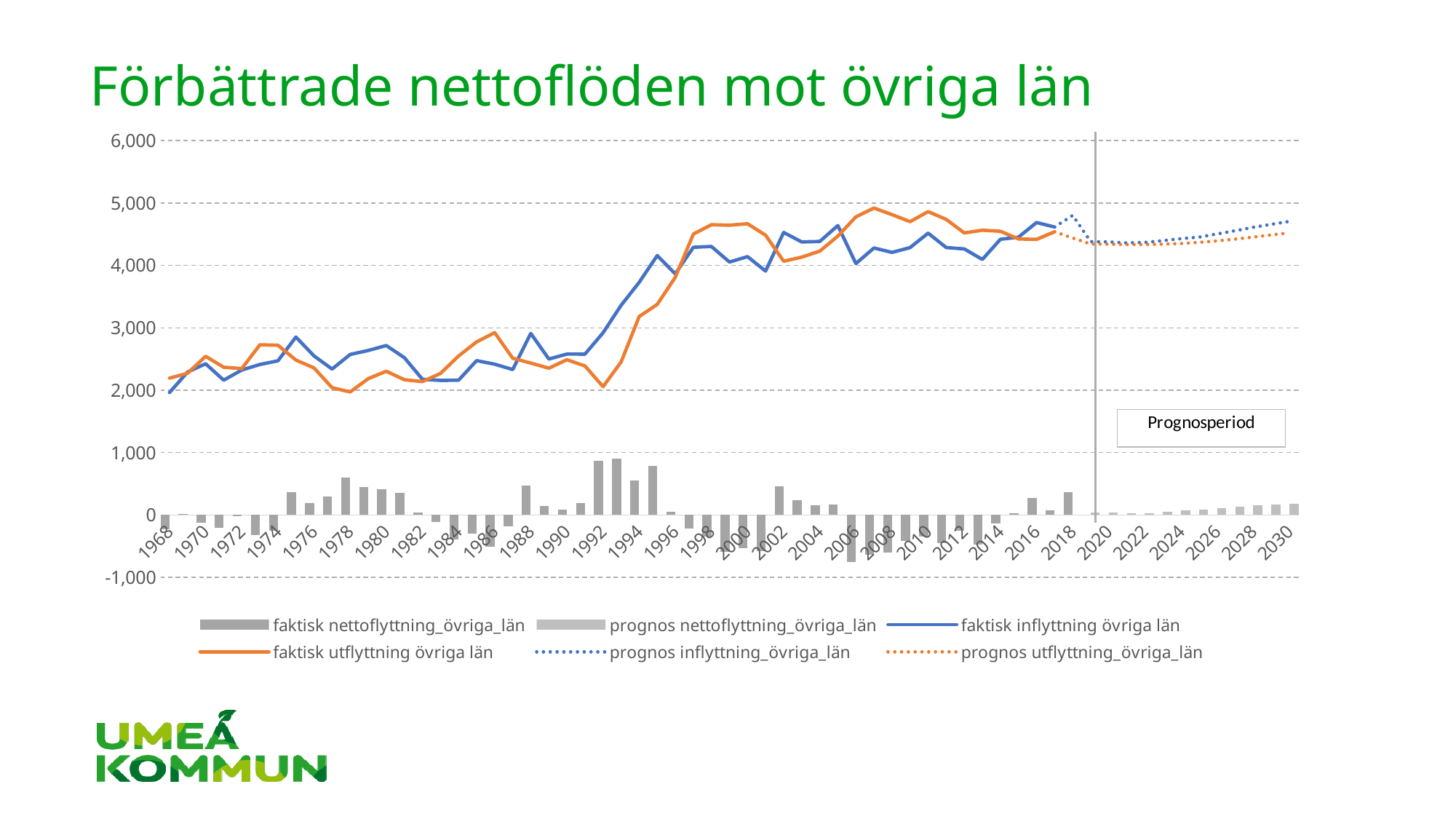
Is the faktisk nettoflyttning_övriga_län bar for 2006 greater or less than 0? less Does faktisk inflyttning övriga län rise or fall between 1990 and 1996? rise What is the title of the chart? Förbättrade nettoflöden mot övriga län Is the faktisk nettoflyttning_övriga_län bar for 1992 greater or less than 1,000? less How many series does the legend list? 6 Is the value of faktisk inflyttning övriga län in 1994 greater or less than 3,000? greater In 2016, which is higher: faktisk inflyttning övriga län or faktisk utflyttning övriga län? faktisk inflyttning övriga län What label is shown in the box to the right of the vertical grey line? Prognosperiod What kind of chart is shown on the slide? A combined bar and line chart In 2008, which is higher: faktisk inflyttning övriga län or faktisk utflyttning övriga län? faktisk utflyttning övriga län